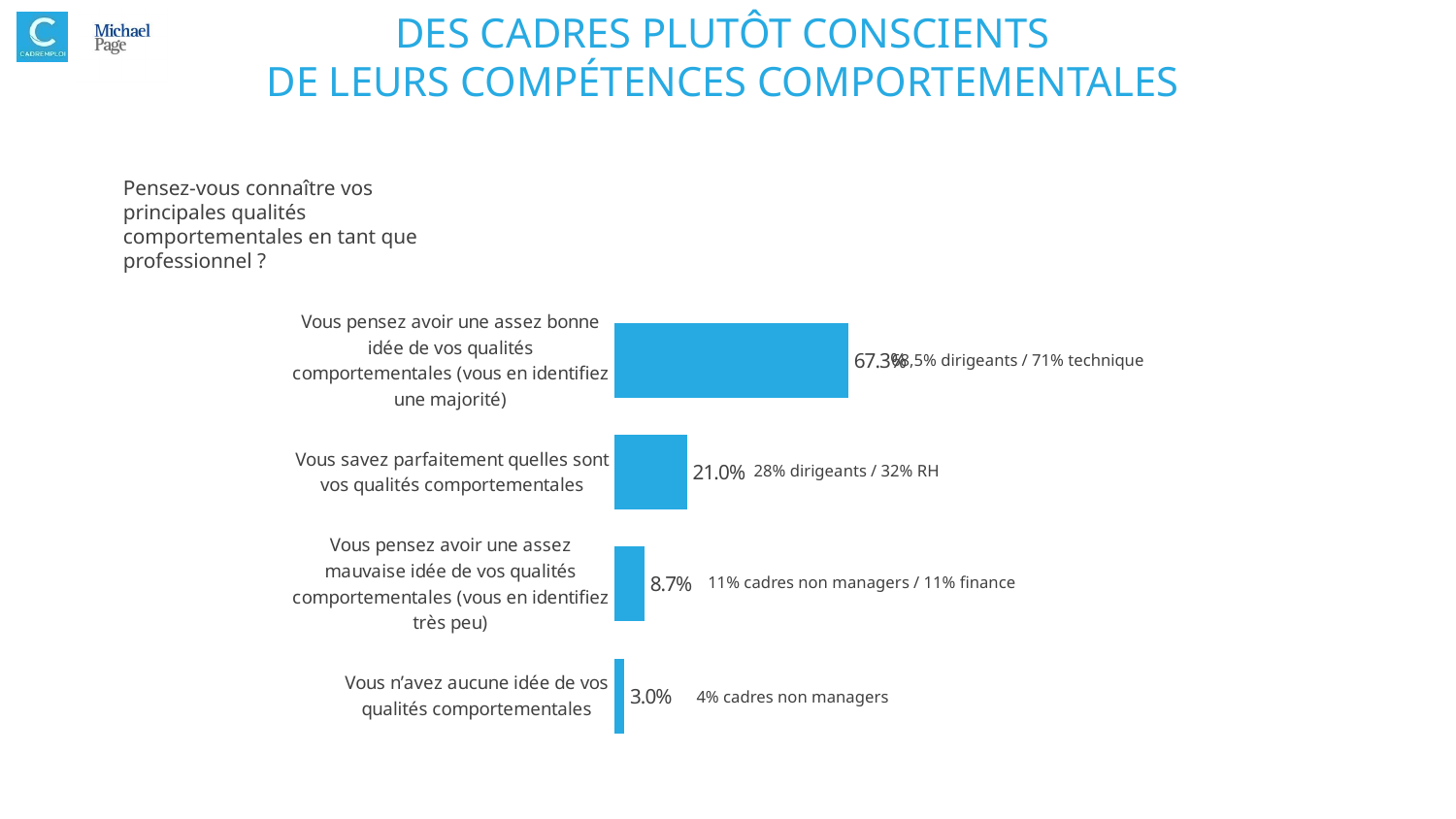
What type of chart is used on this slide? Bar chart What percentage of respondents say they have no idea of their behavioural qualities ("Vous n'avez aucune idée de vos qualités comportementales")? 3.0% Which is larger: the value for "Vous savez parfaitement quelles sont vos qualités comportementales" or the value for "Vous pensez avoir une assez mauvaise idée de vos qualités comportementales"? Vous savez parfaitement quelles sont vos qualités comportementales Which response category has the lowest value in the chart? Vous n'avez aucune idée de vos qualités comportementales What is the difference between the value for "assez bonne idée" (67.3%) and the value for "savez parfaitement" (21.0%)? 46.3% What is the value shown for "Vous pensez avoir une assez mauvaise idée de vos qualités comportementales"? 8.7% What annotation is written next to the bar for "Vous savez parfaitement quelles sont vos qualités comportementales"? 28% dirigeants / 32% RH What is the difference between the value for "assez mauvaise idée" and the value for "aucune idée"? 5.7% Which response category has the highest value in the chart? Vous pensez avoir une assez bonne idée de vos qualités comportementales (vous en identifiez une majorité) What percentage of respondents say they think they have a fairly good idea of their behavioural qualities ("Vous pensez avoir une assez bonne idée de vos qualités comportementales")? 67.3% What is the value shown for "Vous savez parfaitement quelles sont vos qualités comportementales"? 21.0% How many response categories are shown in the chart? 4